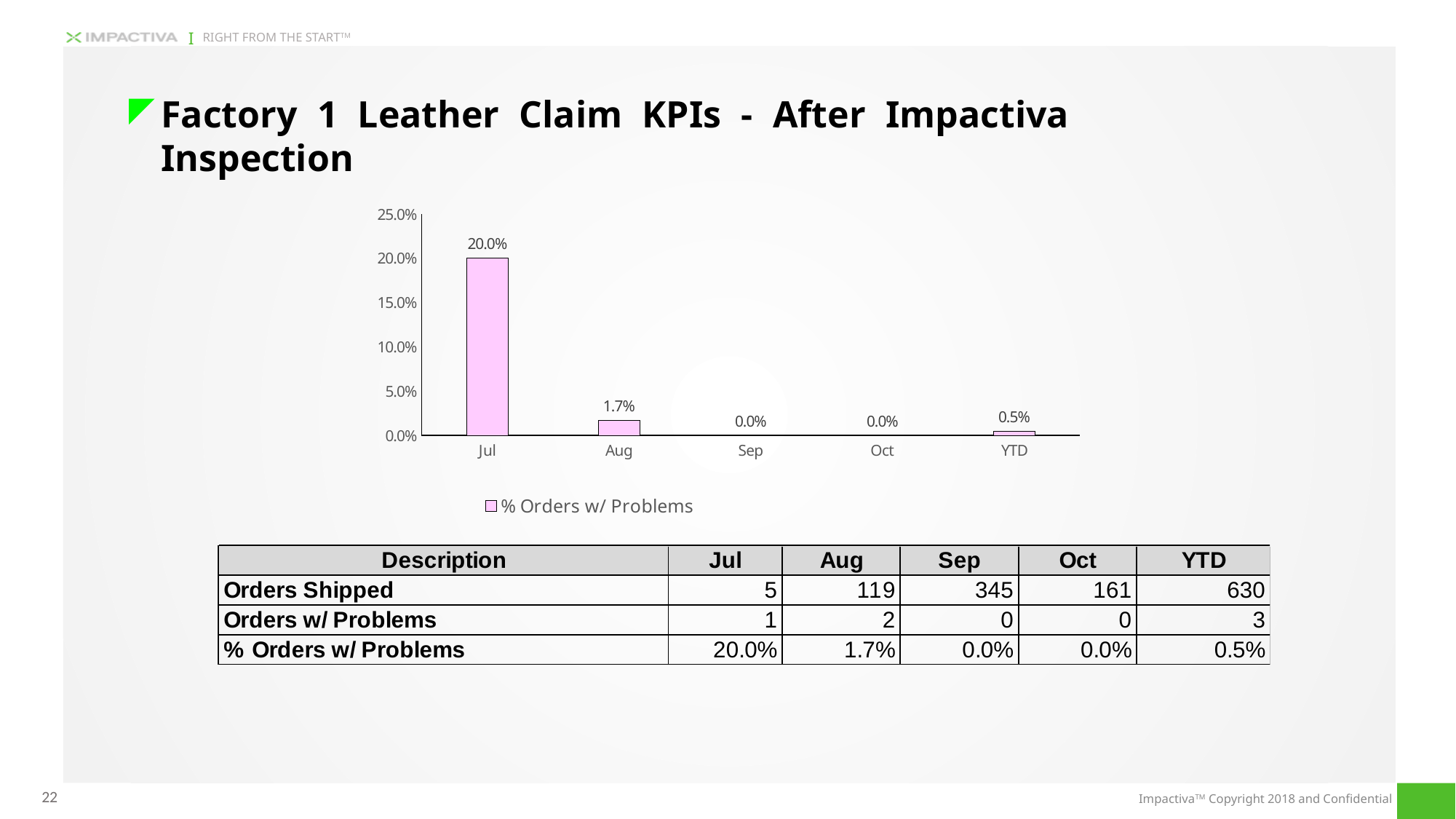
Is the value for Jul greater or less than 15.0%? greater How many categories are shown on the x axis of the chart? 5 Which category has the highest % Orders w/ Problems in the chart? Jul What is the name of the series shown in the chart legend? % Orders w/ Problems Which has a larger % Orders w/ Problems, Aug or YTD? Aug How many series does the chart legend list? 1 What is the % Orders w/ Problems value for Jul in the chart? 20.0% What is the % Orders w/ Problems value for YTD in the chart? 0.5% What is the % Orders w/ Problems value for Sep in the chart? 0.0% What kind of chart is shown on the slide? Bar chart What is the % Orders w/ Problems value for Aug in the chart? 1.7% What is the difference in % Orders w/ Problems between Jul and Aug? 18.3%